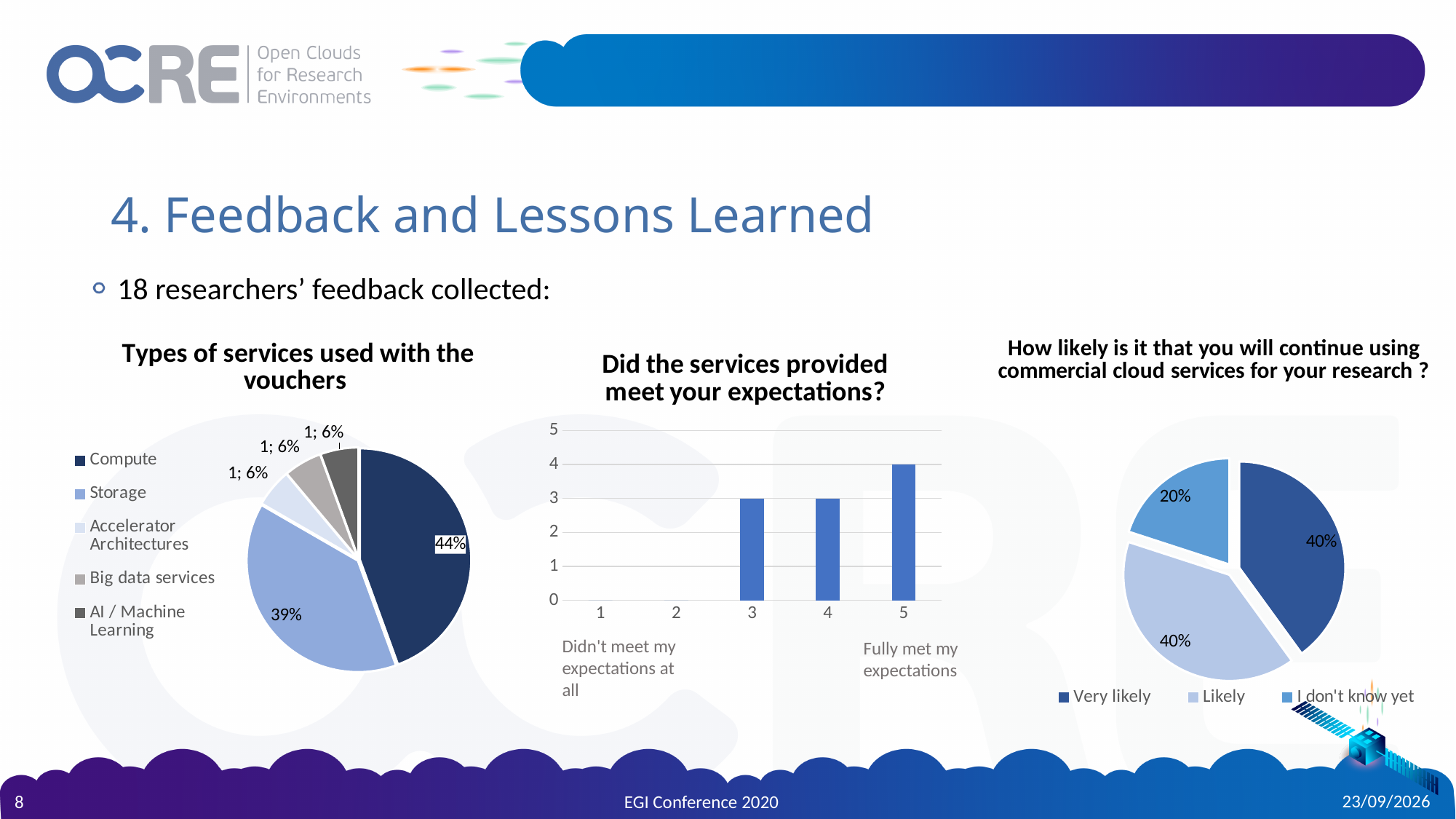
What kind of chart is 'Did the services provided meet your expectations?' Bar chart In the 'Types of services used with the vouchers' pie chart, what share does Storage have? 39% In the 'Types of services used with the vouchers' pie chart, what is the difference between the Compute and Storage shares? 5% How many series does the legend of the 'How likely is it that you will continue using commercial cloud services for your research?' pie chart list? 3 In the 'How likely is it that you will continue using commercial cloud services for your research?' pie chart, what share is 'I don't know yet'? 20% In the 'Did the services provided meet your expectations?' chart, is the value for rating 5 greater or less than 3? greater How many categories does the legend of the 'Types of services used with the vouchers' pie chart list? 5 In the 'Did the services provided meet your expectations?' chart, what is the value for rating 5? 4 In the 'Types of services used with the vouchers' pie chart, what share does Compute have? 44% In the 'Did the services provided meet your expectations?' chart, which rating has the highest value? 5 In the 'Types of services used with the vouchers' pie chart, which category has the largest share? Compute In the 'Did the services provided meet your expectations?' chart, what is the value for rating 3? 3